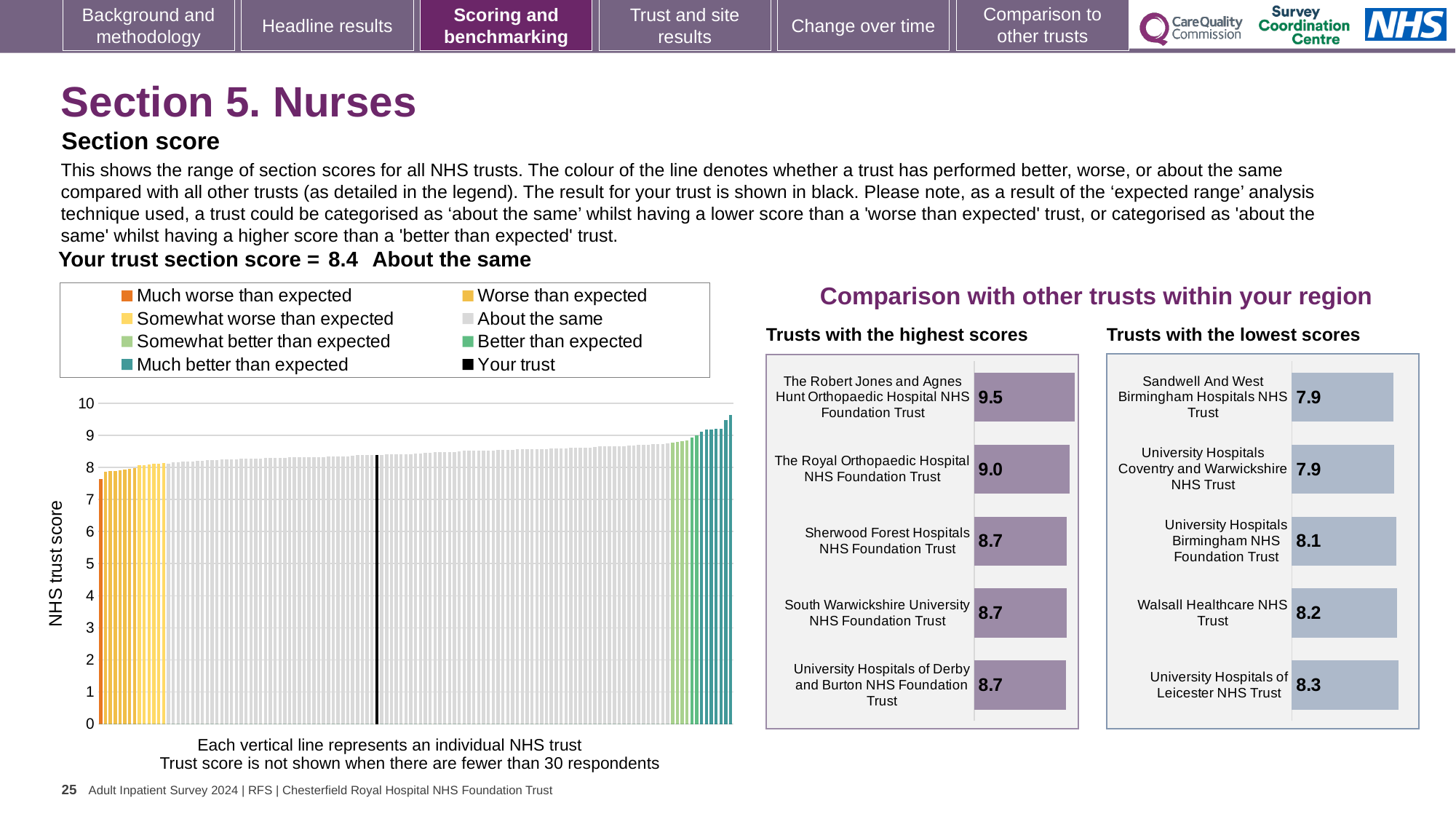
In the 'Trusts with the highest scores' chart, which trust has the highest score? The Robert Jones and Agnes Hunt Orthopaedic Hospital NHS Foundation Trust What kind of chart is the large 'NHS trust score' chart on the left of the slide? bar chart According to the slide, what is your trust's section score for Nurses? 8.4 In the 'Trusts with the lowest scores' chart, what is the score for Walsall Healthcare NHS Trust? 8.2 In the 'Trusts with the lowest scores' chart, which trust has the highest score? University Hospitals of Leicester NHS Trust In the 'Trusts with the lowest scores' chart, what is the difference between the scores of University Hospitals of Leicester NHS Trust and Sandwell And West Birmingham Hospitals NHS Trust? 0.4 In the 'Trusts with the highest scores' chart, what is the score for The Robert Jones and Agnes Hunt Orthopaedic Hospital NHS Foundation Trust? 9.5 In the 'NHS trust score' chart on the left, is the value of the black 'Your trust' bar greater or less than 5? greater How many entries does the legend of the 'NHS trust score' chart on the left list? 8 Which has the higher score: Sherwood Forest Hospitals NHS Foundation Trust in the 'highest scores' chart or University Hospitals Birmingham NHS Foundation Trust in the 'lowest scores' chart? Sherwood Forest Hospitals NHS Foundation Trust How many trusts are listed in the 'Trusts with the highest scores' chart? 5 In the 'Trusts with the highest scores' chart, what is the difference between the scores of The Robert Jones and Agnes Hunt Orthopaedic Hospital NHS Foundation Trust and The Royal Orthopaedic Hospital NHS Foundation Trust? 0.5